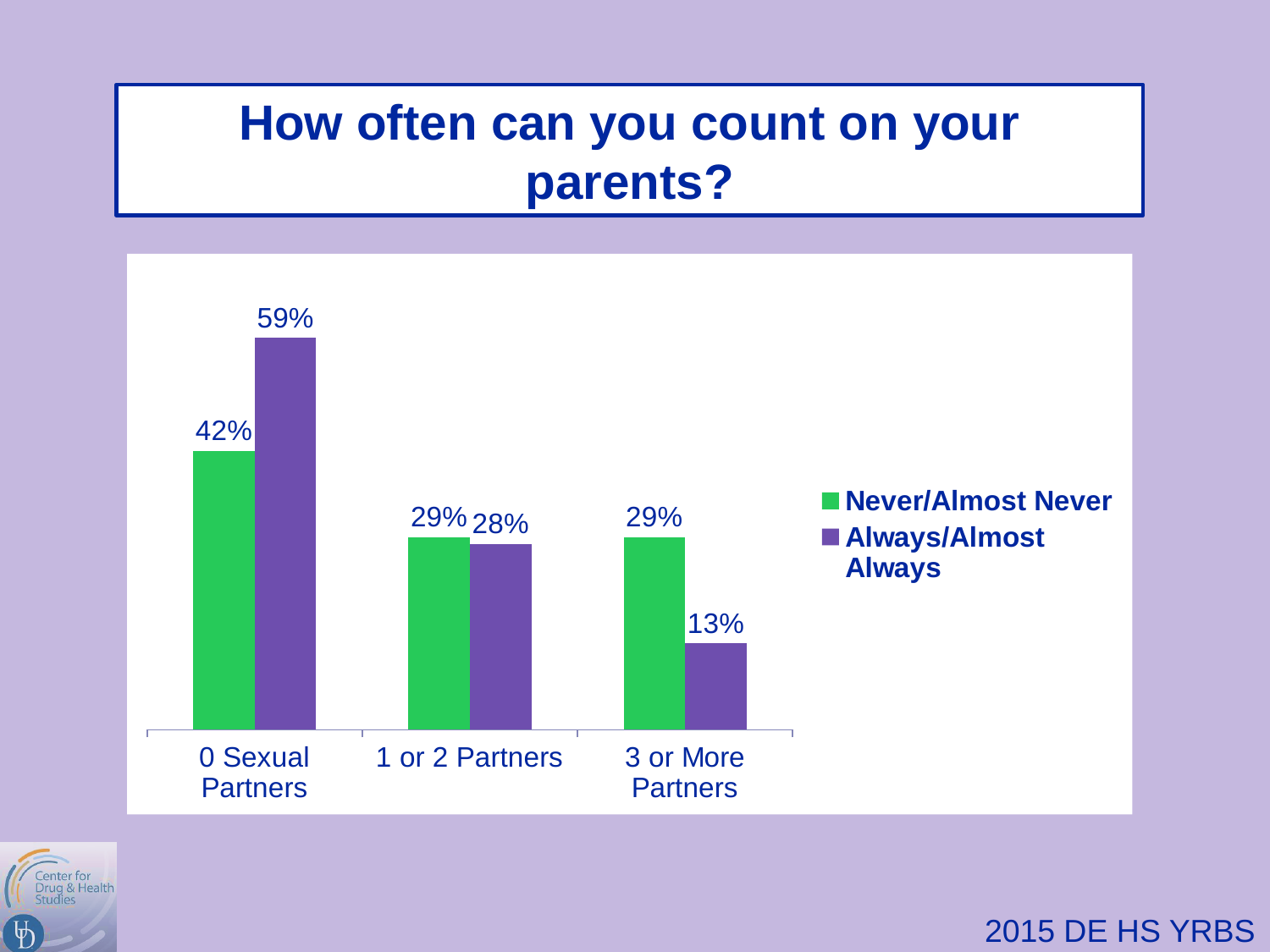
How many series does the legend list? 2 For 3 or More Partners, which is larger: Never/Almost Never or Always/Almost Always? Never/Almost Never What kind of chart is shown on the slide? Bar chart What is the difference between the Always/Almost Always and Never/Almost Never values for 0 Sexual Partners? 17% What is the value for Always/Almost Always among students with 0 Sexual Partners? 59% Which category has the highest Always/Almost Always value? 0 Sexual Partners What is the value for Always/Almost Always among students with 3 or More Partners? 13% What is the value for Never/Almost Never among students with 1 or 2 Partners? 29% Which category has the lowest Always/Almost Always value? 3 or More Partners What is the value for Never/Almost Never among students with 0 Sexual Partners? 42% What is the difference between the Never/Almost Never and Always/Almost Always values for 3 or More Partners? 16% How many categories are shown on the x axis? 3